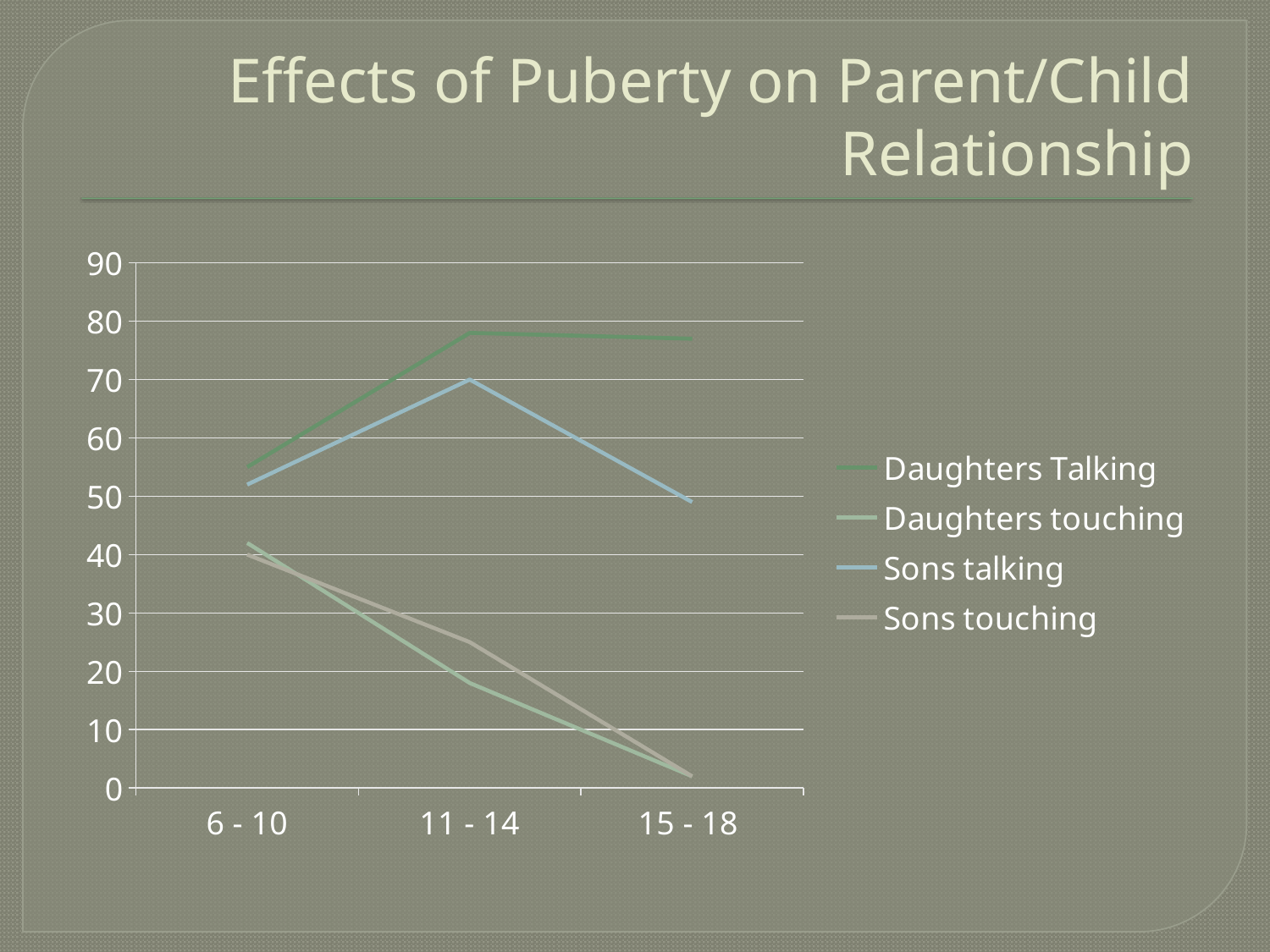
How many age-group categories are shown on the x axis? 3 What kind of chart is shown on the slide? line chart Is the value for Daughters touching at 15 - 18 greater or less than 10? less What is the title of the slide containing the chart? Effects of Puberty on Parent/Child Relationship Does the Daughters touching series rise or fall from 6 - 10 to 15 - 18? fall Is the value for Sons touching at 6 - 10 greater or less than 50? less Is the value for Daughters Talking at 11 - 14 greater or less than 70? greater Which series is shown with a blue line in the legend? Sons talking At the 11 - 14 age group, which is larger: Daughters Talking or Sons talking? Daughters Talking How many series does the legend list? 4 Which series has the highest value at the 11 - 14 age group? Daughters Talking